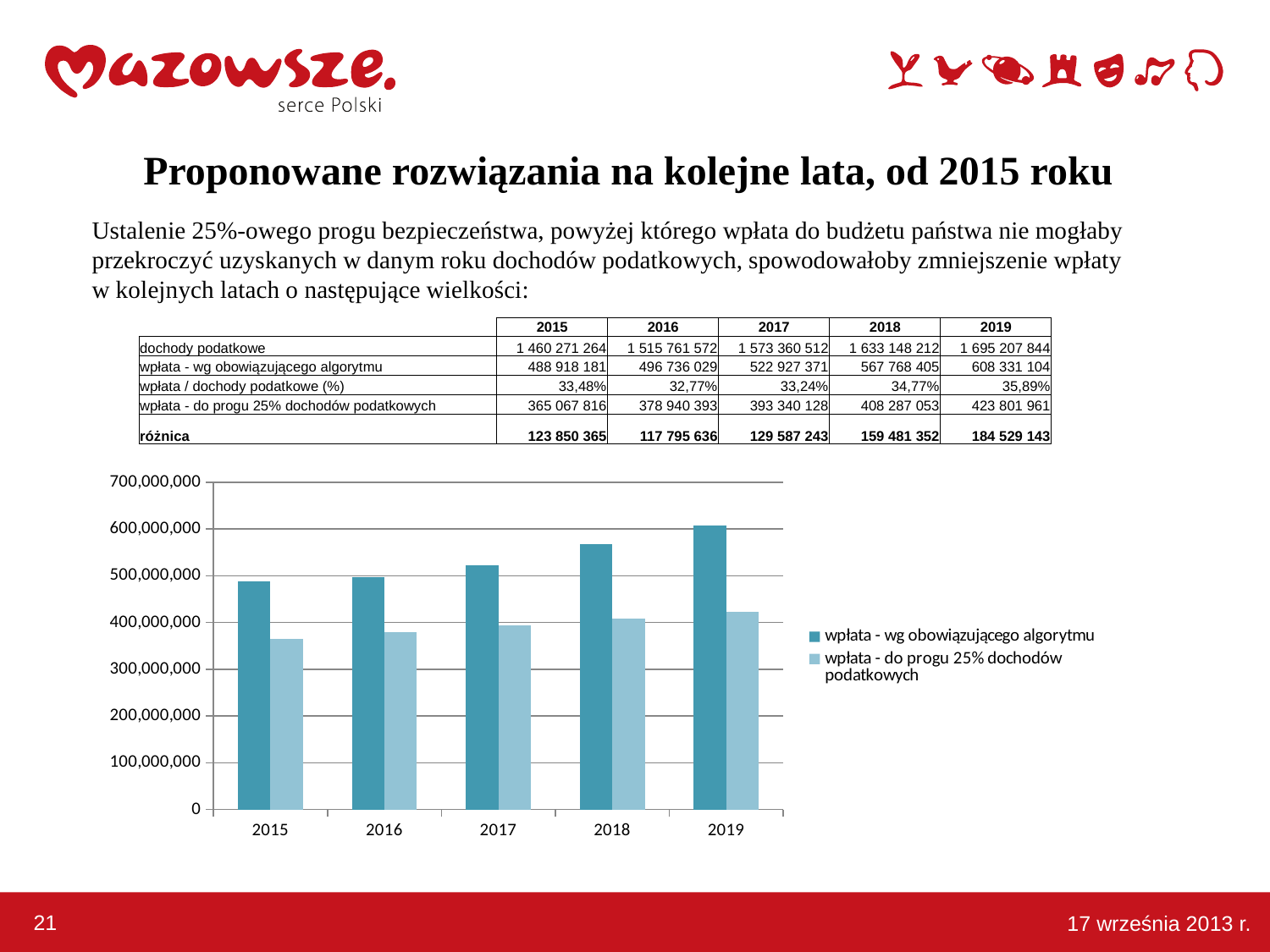
In which year is the bar for 'wpłata - do progu 25% dochodów podatkowych' the lowest? 2015 What kind of chart is shown on the slide? bar chart Which series is shown in the lighter blue colour in the chart? wpłata - do progu 25% dochodów podatkowych Do the values for 'wpłata - wg obowiązującego algorytmu' rise or fall from 2015 to 2019? rise In which year is the bar for 'wpłata - wg obowiązującego algorytmu' the highest? 2019 How many series does the chart legend list? 2 According to the table on the slide, what is the 'różnica' (difference) between the two plotted series for 2019? 184 529 143 Is the value for 'wpłata - do progu 25% dochodów podatkowych' in 2015 greater or less than 400,000,000? less According to the table on the slide, what is the value of 'wpłata - wg obowiązującego algorytmu' for 2019? 608 331 104 In 2019, which is larger: 'wpłata - wg obowiązującego algorytmu' or 'wpłata - do progu 25% dochodów podatkowych'? wpłata - wg obowiązującego algorytmu How many years are shown on the x axis of the chart? 5 Is the value for 'wpłata - wg obowiązującego algorytmu' in 2017 greater or less than 500,000,000? greater